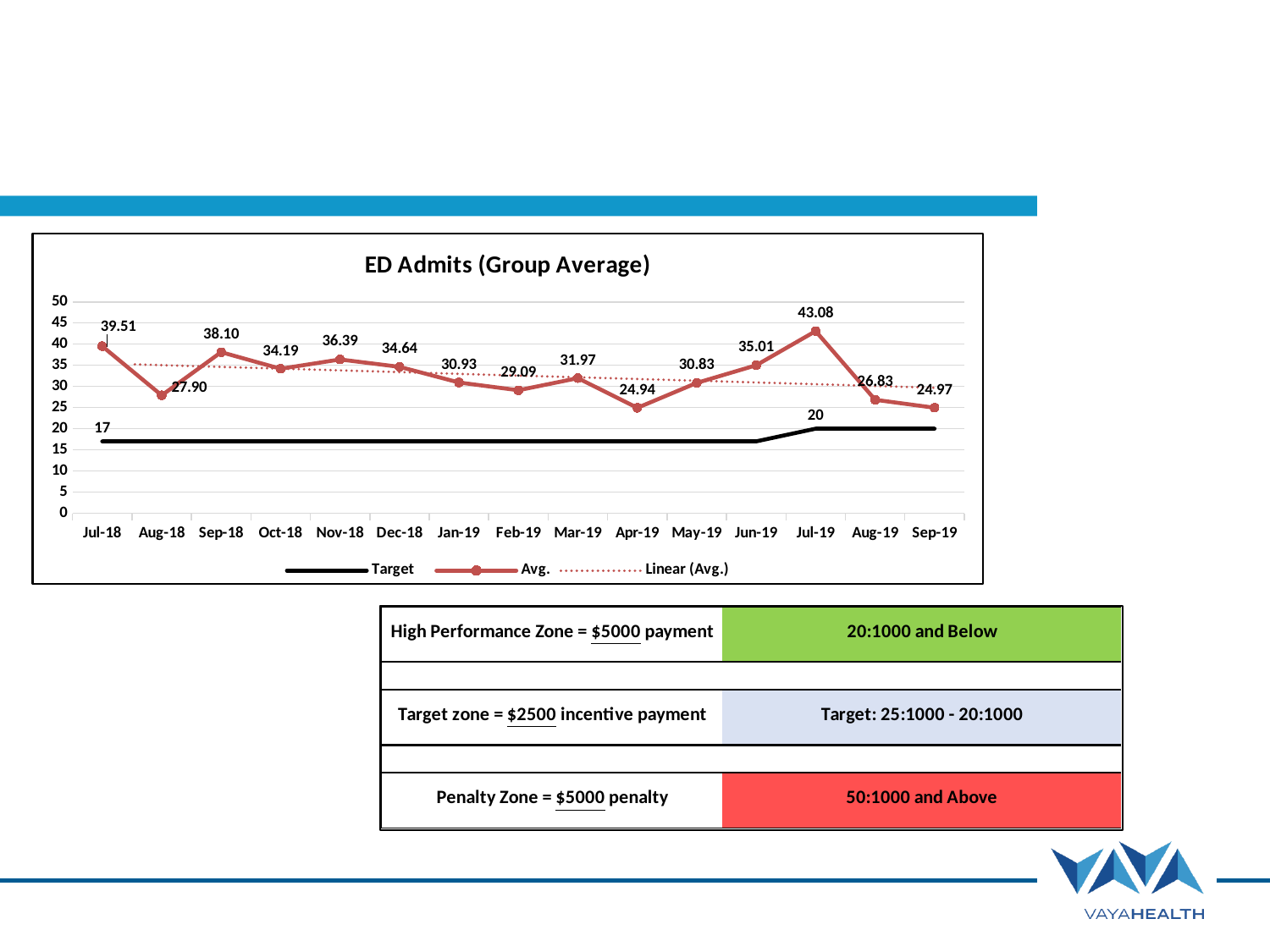
How many months are plotted on the x axis of the ED Admits (Group Average) chart? 15 What is the difference between the Avg. values for Jul-19 and Aug-19 in the ED Admits (Group Average) chart? 16.25 Which month has the lowest Avg. value in the ED Admits (Group Average) chart? Apr-19 What kind of chart is the ED Admits (Group Average) chart? Line chart Does the Linear (Avg.) trend line in the ED Admits (Group Average) chart rise or fall from Jul-18 to Sep-19? Fall What is the Avg. value for Jul-19 in the ED Admits (Group Average) chart? 43.08 What is the Avg. value for Apr-19 in the ED Admits (Group Average) chart? 24.94 How many series does the legend of the ED Admits (Group Average) chart list? 3 Which is larger in the ED Admits (Group Average) chart, the Avg. value for Sep-18 or for Nov-18? Sep-18 What Target value is labelled at Jul-19 in the ED Admits (Group Average) chart? 20 What is the Avg. value for Jul-18 in the ED Admits (Group Average) chart? 39.51 Which month has the highest Avg. value in the ED Admits (Group Average) chart? Jul-19